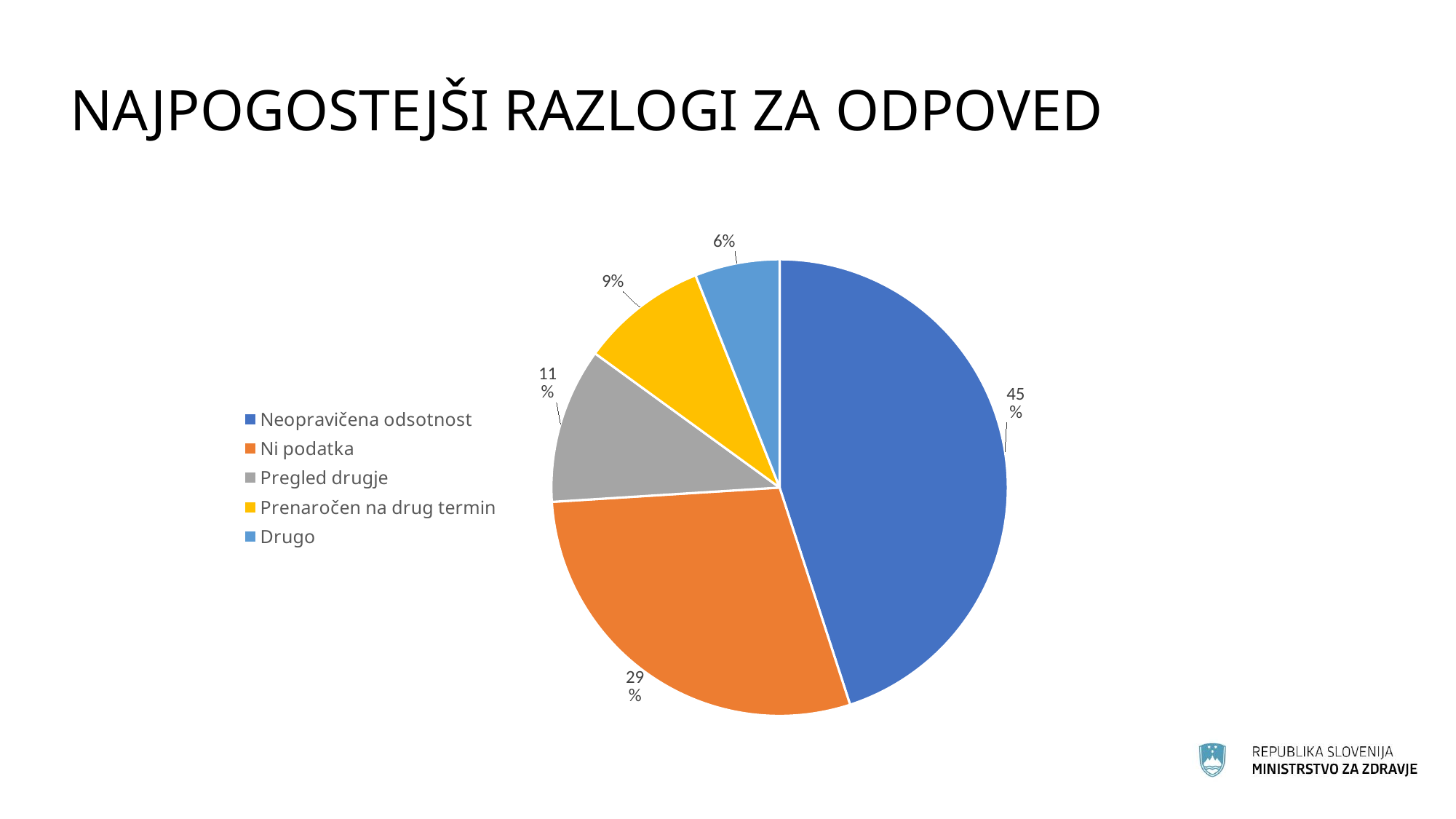
What kind of chart is shown on the slide? pie chart How many categories does the pie chart show? 5 Which category has the smallest slice of the pie? Drugo What is the title of the slide containing the chart? NAJPOGOSTEJŠI RAZLOGI ZA ODPOVED What share of the pie does Ni podatka have? 29% What share of the pie does Prenaročen na drug termin have? 9% Which category has the largest slice of the pie? Neopravičena odsotnost What is the difference in percentage points between Neopravičena odsotnost and Ni podatka? 16 Which is larger, the share for Pregled drugje or the share for Prenaročen na drug termin? Pregled drugje What share of the pie does Neopravičena odsotnost have? 45%